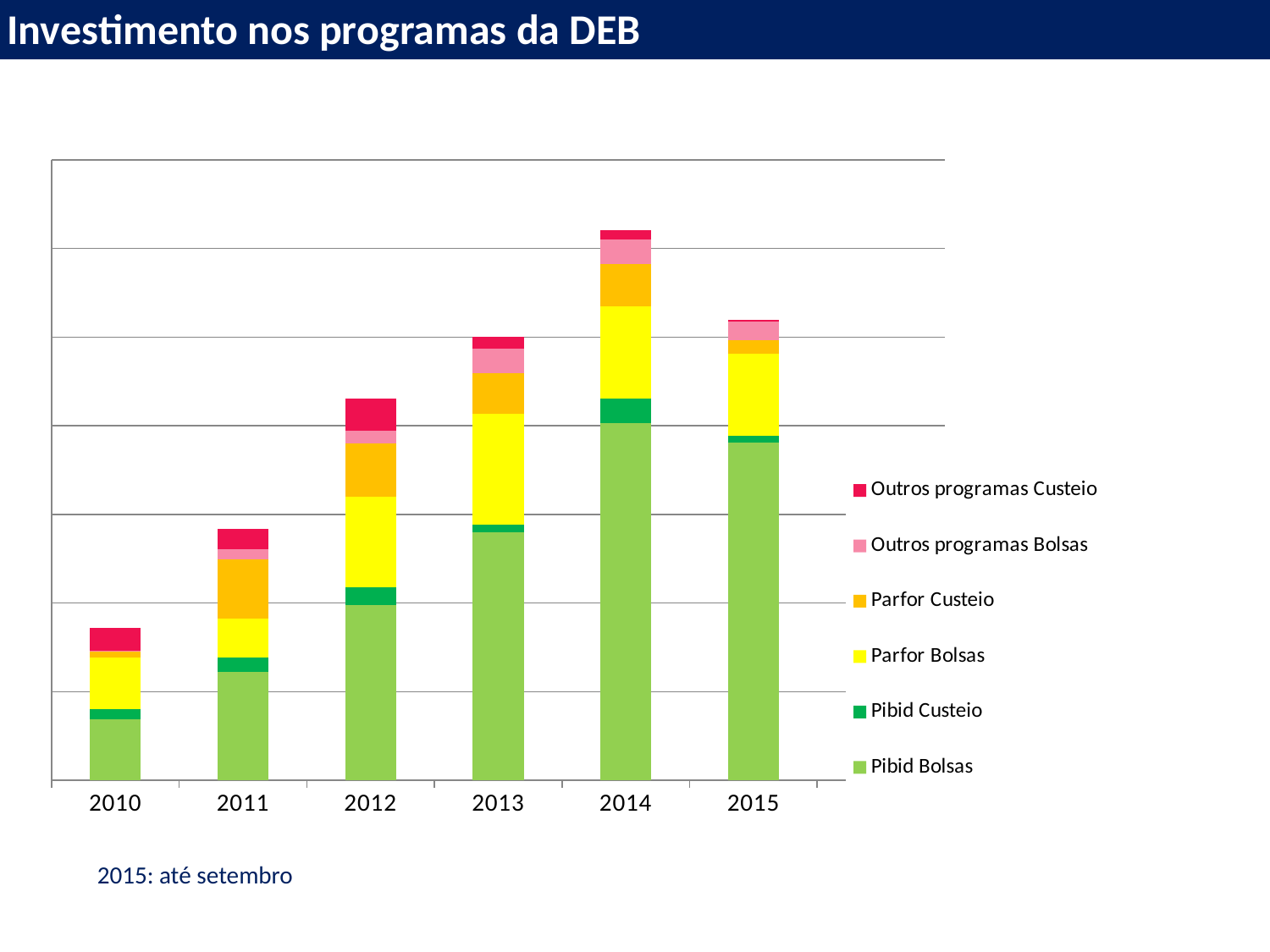
Which year has the shortest stacked bar (lowest total investment)? 2010 Which year has the larger total investment, 2012 or 2013? 2013 What is the title of the slide containing the chart? Investimento nos programas da DEB How many years are shown on the x axis of the chart? 6 Which series is shown at the bottom of each stacked bar? Pibid Bolsas How many series does the legend list? 6 Do the total investments rise or fall from 2010 to 2014? Rise Which series makes up the largest part of the 2014 bar? Pibid Bolsas What kind of chart is shown on the slide? Stacked bar chart Which year has the larger total investment, 2014 or 2015? 2014 Which year has the tallest stacked bar (highest total investment)? 2014